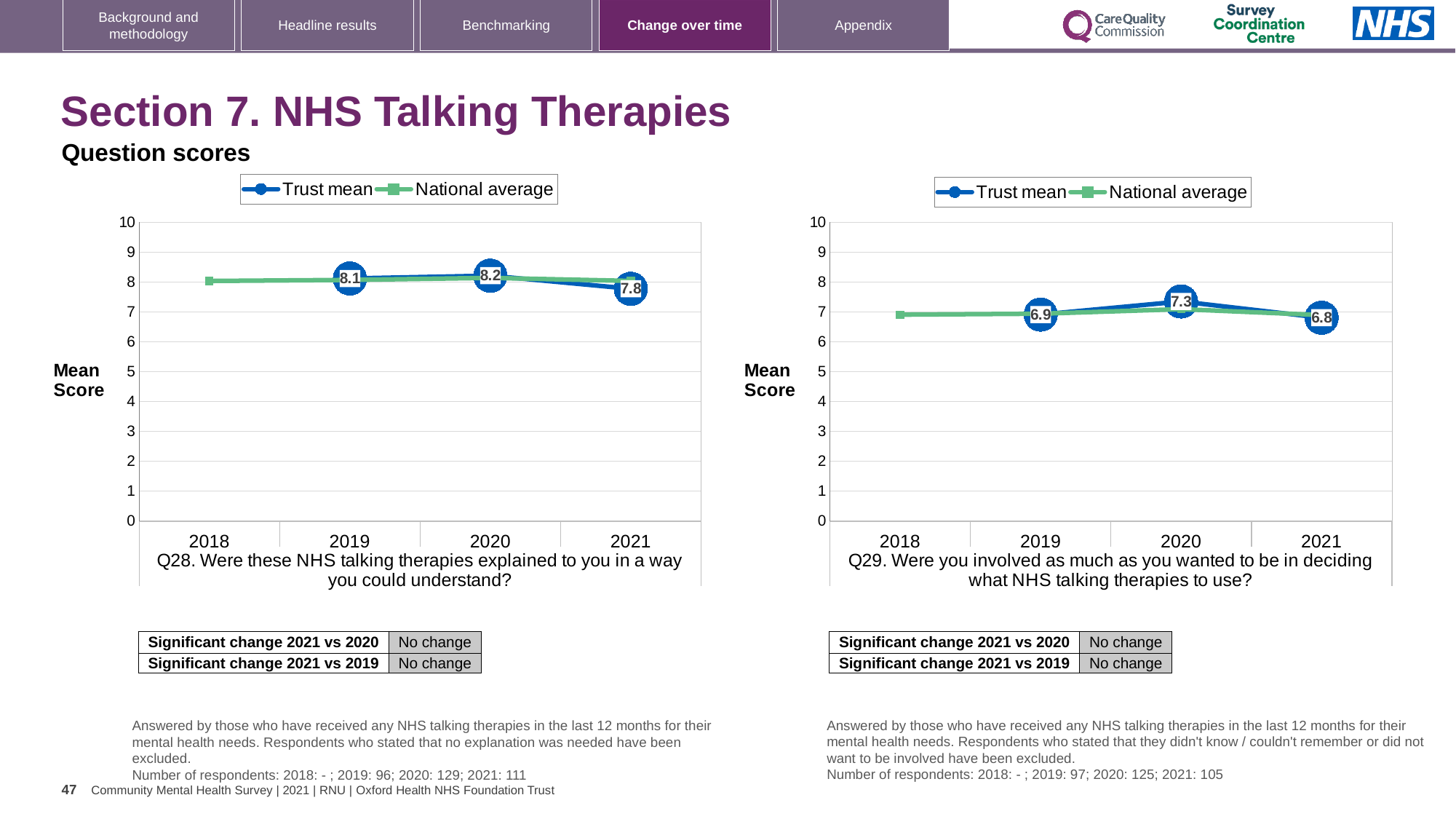
In the Q29 chart (right), what is the difference between the Trust mean for 2020 and 2021? 0.5 How many series does the legend of the Q28 chart (left) list? 2 In the Q29 chart (right), what is the Trust mean for 2019? 6.9 In the Q29 chart (right), what is the Trust mean for 2020? 7.3 In the Q28 chart (left), what is the Trust mean for 2020? 8.2 In the Q29 chart (right), which year has the lowest Trust mean? 2021 In the Q28 chart (left), is the Trust mean higher in 2019 or 2021? 2019 In the Q28 chart (left), what is the Trust mean for 2021? 7.8 In the Q28 chart (left), does the Trust mean rise or fall from 2020 to 2021? Fall In the Q29 chart (right), is the National average for 2018 greater or less than 8? less What kind of chart is the Q29 chart (right)? Line chart In the Q28 chart (left), which year has the highest Trust mean? 2020